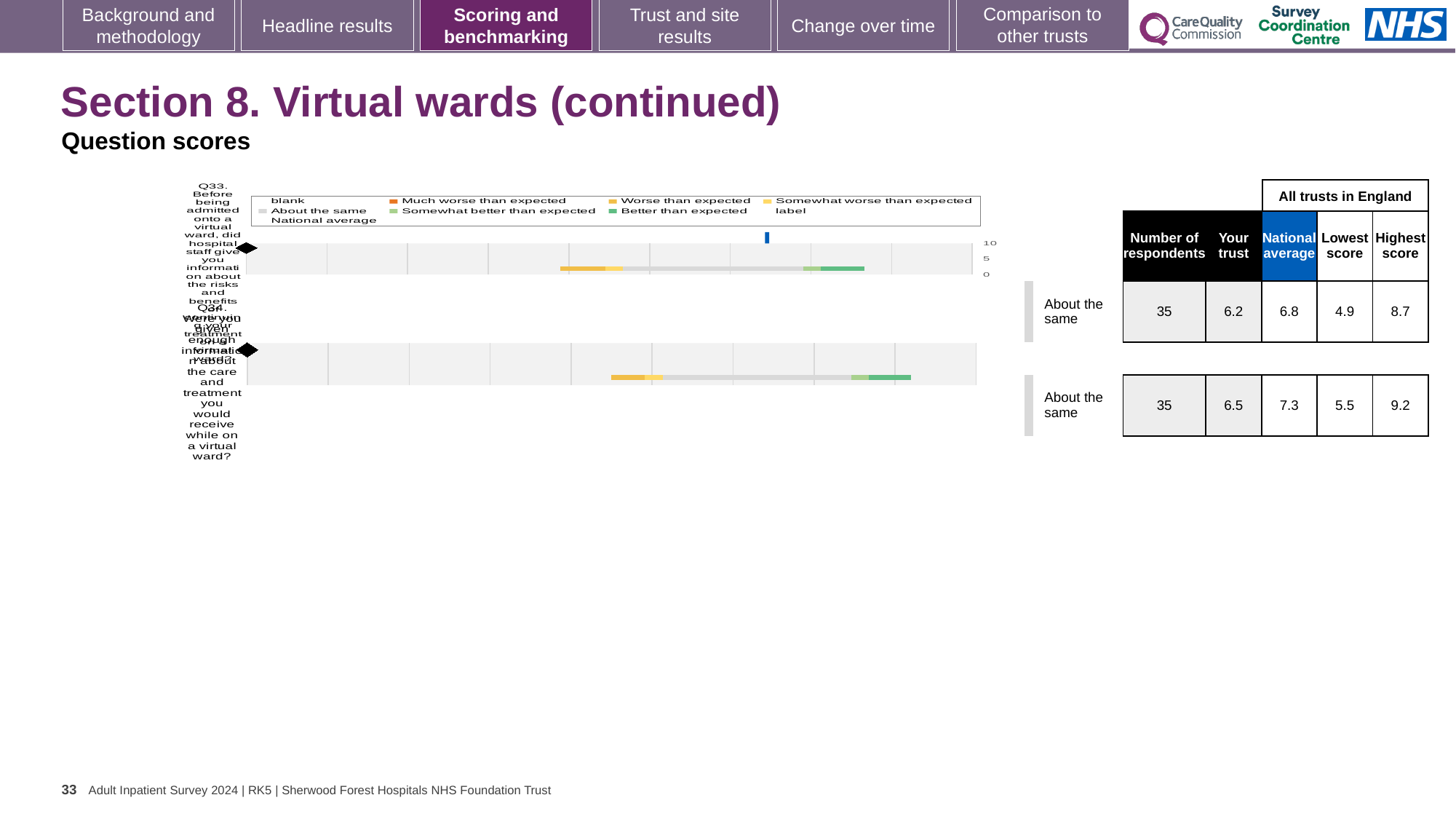
What colour represents 'Better than expected' in the chart legend? green Which question has the higher 'Highest score' across all trusts in England? Q34 Which question has the higher 'Your trust' score, Q33 or Q34? Q34 What is the difference between the highest score and the lowest score for Q33? 3.8 What is the national average score for Q34? 7.3 How much higher is the national average than the 'Your trust' score for Q34? 0.8 How many respondents answered Q33? 35 What kind of chart is used to show the question scores for Q33 and Q34? bar chart What is the lowest score among all trusts in England for Q34? 5.5 What is the 'Your trust' score for Q33? 6.2 How many questions (categories) are plotted in the chart? 2 What benchmark category is shown for Q33? About the same